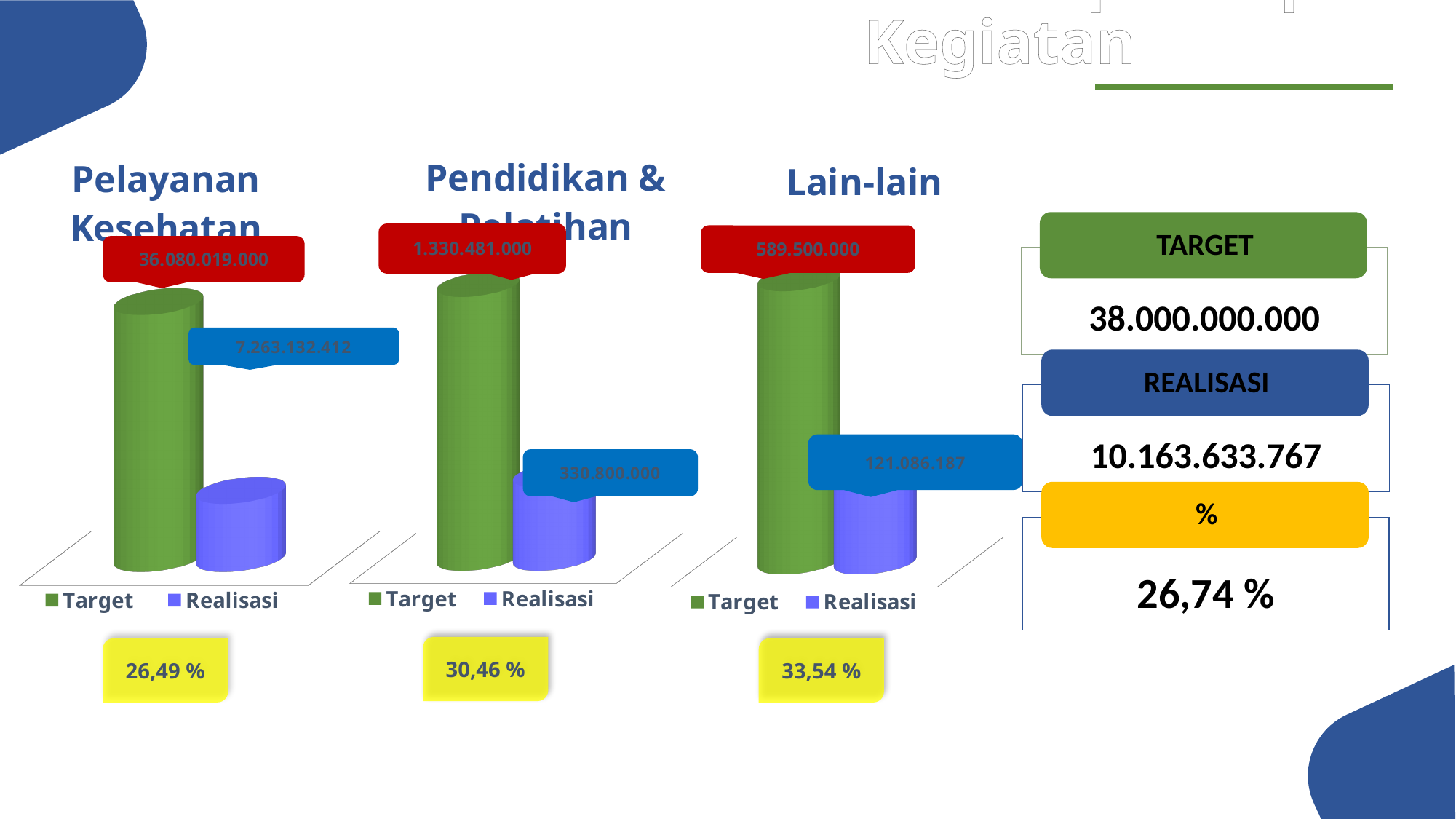
What kind of chart is the Pendidikan & Pelatihan chart? Bar chart How many series does the legend of the Pelayanan Kesehatan chart list? 2 In the Pendidikan & Pelatihan chart, what is the difference between the Target and Realisasi values? 999.681.000 In the Lain-lain chart, what is the difference between the Target and Realisasi values? 468.413.813 In the Pendidikan & Pelatihan chart, what is the value of the Target bar? 1.330.481.000 In the Lain-lain chart, what is the value of the Realisasi bar? 121.086.187 In the Lain-lain chart, which bar is taller, Target or Realisasi? Target In the Lain-lain chart, what is the value of the Target bar? 589.500.000 In the Pelayanan Kesehatan chart, what is the value of the Target bar? 36.080.019.000 What colour is the Realisasi bar in the Lain-lain chart? Blue (purple-blue) In the Pelayanan Kesehatan chart, what is the value of the Realisasi bar? 7.263.132.412 In the Pendidikan & Pelatihan chart, what is the value of the Realisasi bar? 330.800.000